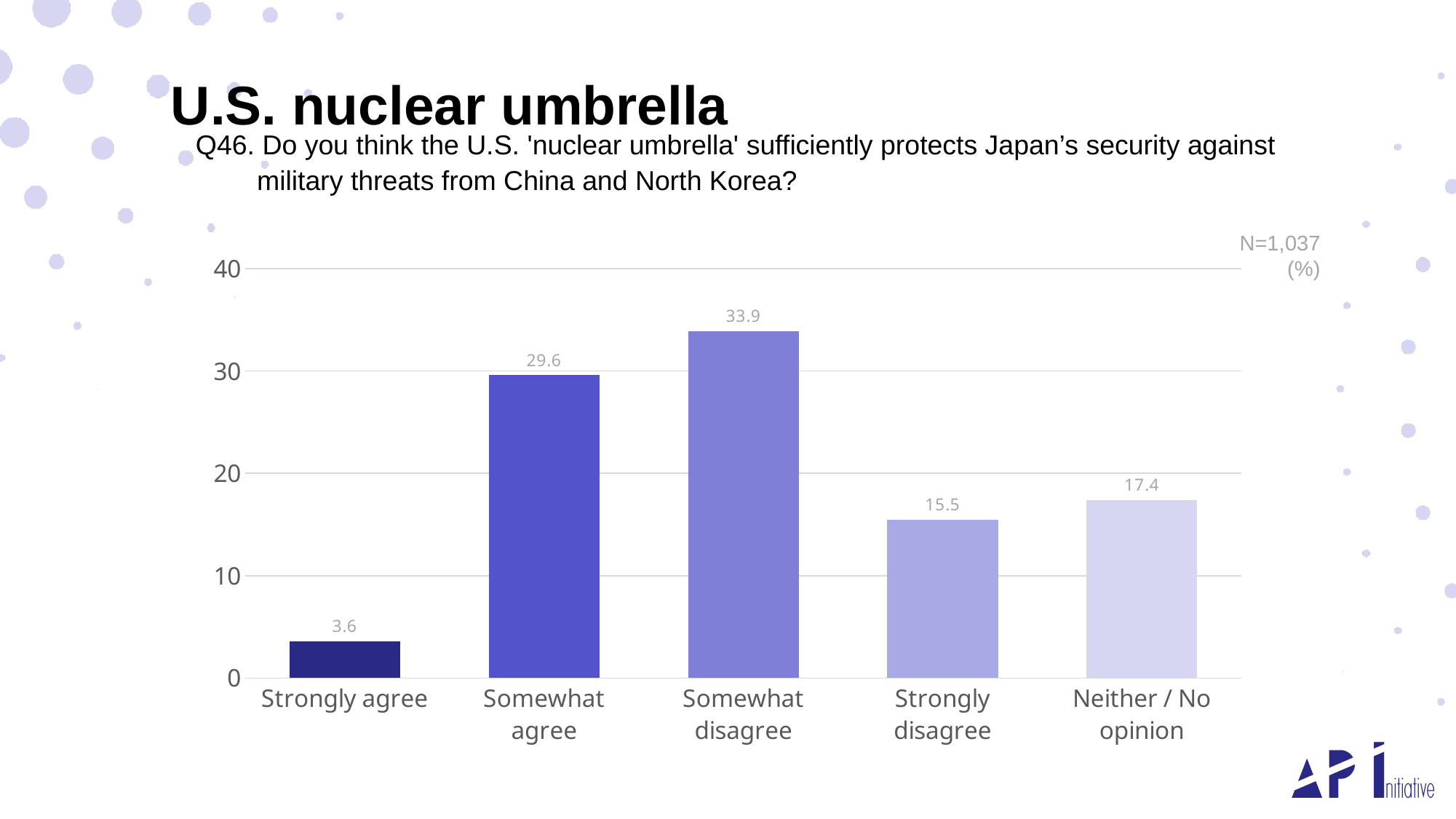
Which category has the lowest value? Strongly agree What sample size (N) is shown on the chart? N=1,037 What is the difference between Somewhat disagree and Somewhat agree? 4.3 What is the value for Neither / No opinion? 17.4 What kind of chart is shown on the slide? bar chart Which is larger, Strongly disagree or Neither / No opinion? Neither / No opinion What is the value for Strongly agree? 3.6 What is the difference between Neither / No opinion and Strongly disagree? 1.9 Is the value for Somewhat agree greater or less than 20? greater What is the value for Somewhat disagree? 33.9 Which category has the highest value? Somewhat disagree How many categories are shown on the x axis? 5